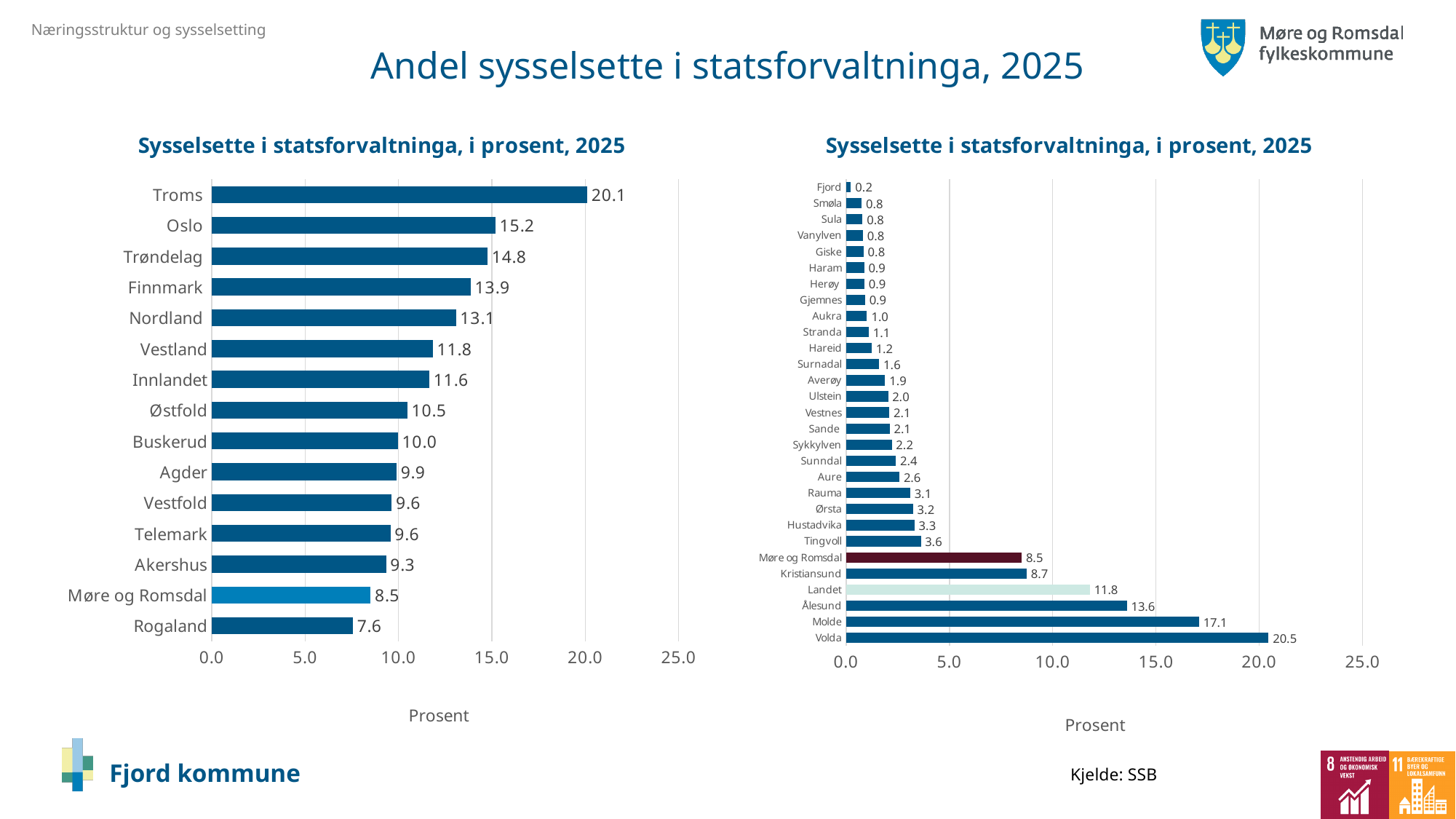
On the left chart, which category has the lowest value? Rogaland What kind of chart is the right chart? bar chart On the left chart, which is larger, Vestland or Innlandet? Vestland On the right chart, which bar is shown in a dark red colour? Møre og Romsdal On the right chart, what is the value for Landet? 11.8 On the left chart, what is the value for Møre og Romsdal? 8.5 On the left chart, what is the difference between Oslo and Trøndelag? 0.4 On the right chart, what is the difference between Molde and Ålesund? 3.5 On the left chart, what is the value for Troms? 20.1 On the right chart, what is the value for Volda? 20.5 How many categories are shown on the left chart? 15 On the right chart, which category has the highest value? Volda